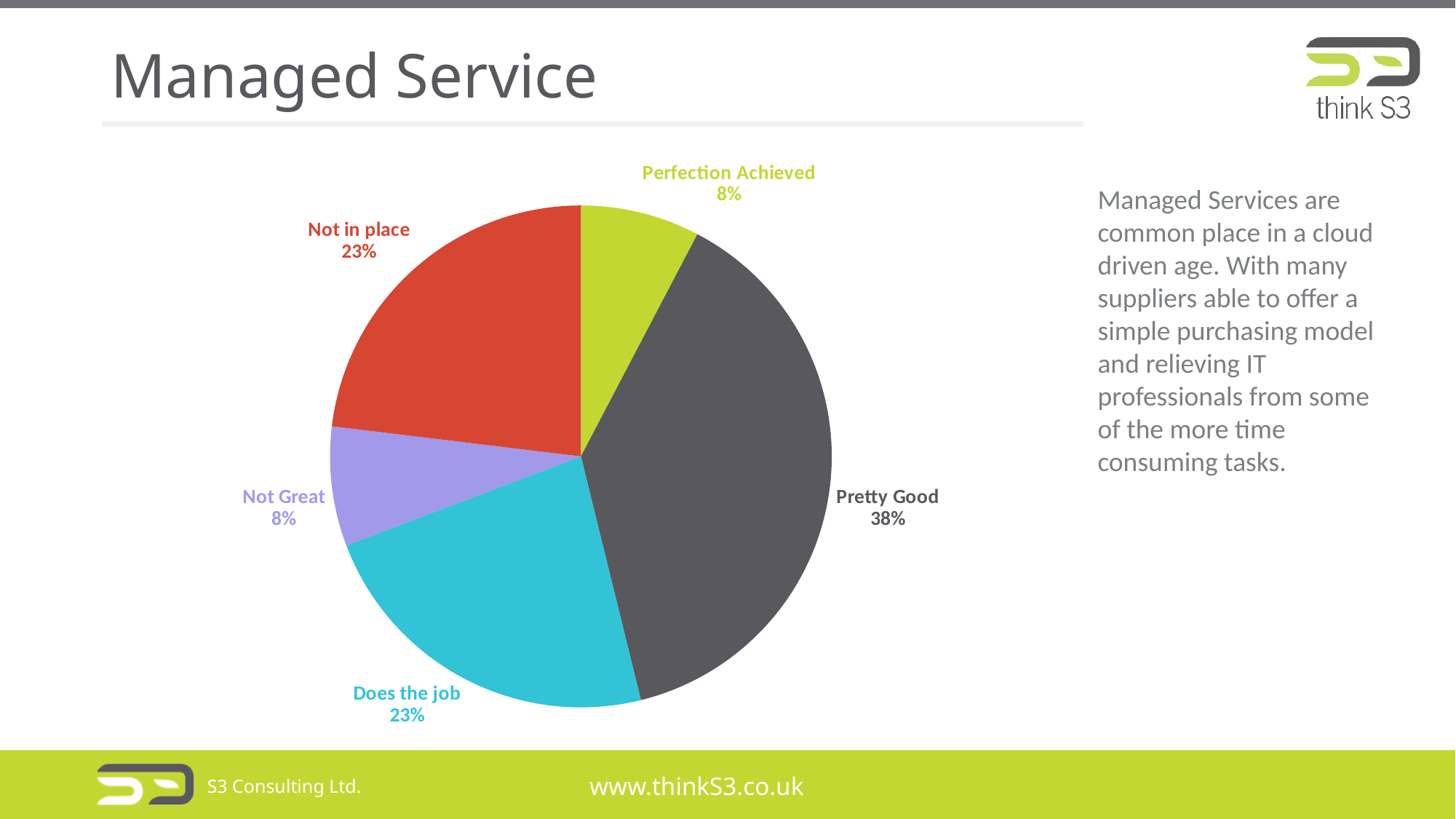
What colour is the Does the job slice? Cyan Which is larger, the share for Pretty Good or the share for Does the job? Pretty Good What is the title of the slide containing the pie chart? Managed Service What percentage is shown for Perfection Achieved? 8% What is the difference in percentage points between Not in place and Perfection Achieved? 15 What percentage is shown for Not in place? 23% What is the difference in percentage points between Pretty Good and Not Great? 30 What kind of chart is shown on the slide? Pie chart What percentage is shown for Pretty Good? 38% What percentage is shown for Does the job? 23% Which category has the largest share of the pie? Pretty Good How many slices does the pie chart have? 5